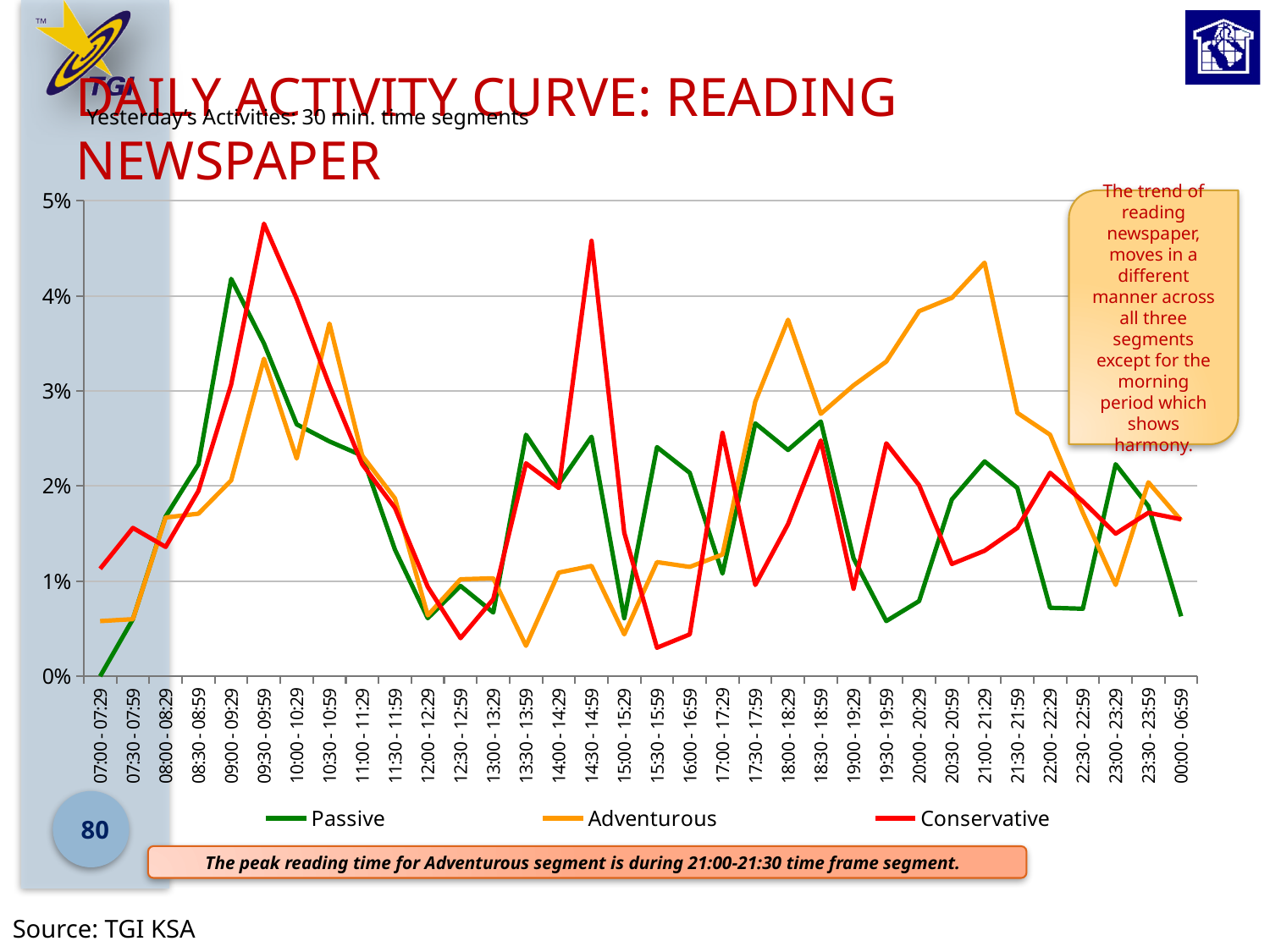
What kind of chart is shown on the slide? Line chart Is the value for Conservative at 15:30 - 15:59 greater or less than 1%? less At 21:00 - 21:29, which series has the higher value, Adventurous or Passive? Adventurous Is the value for Passive at 00:00 - 06:59 greater or less than 1%? less Is the value for Conservative at 09:30 - 09:59 greater or less than 4%? greater Does the Adventurous series rise or fall from 17:00 - 17:29 to 21:00 - 21:29? Rise Which series reaches its peak during the 21:00 - 21:29 time segment? Adventurous At 14:30 - 14:59, which series has the higher value, Conservative or Adventurous? Conservative Which colour represents the Conservative series in the chart? Red How many series does the legend list? 3 In which time segment does the Passive series reach its highest value? 09:00 - 09:29